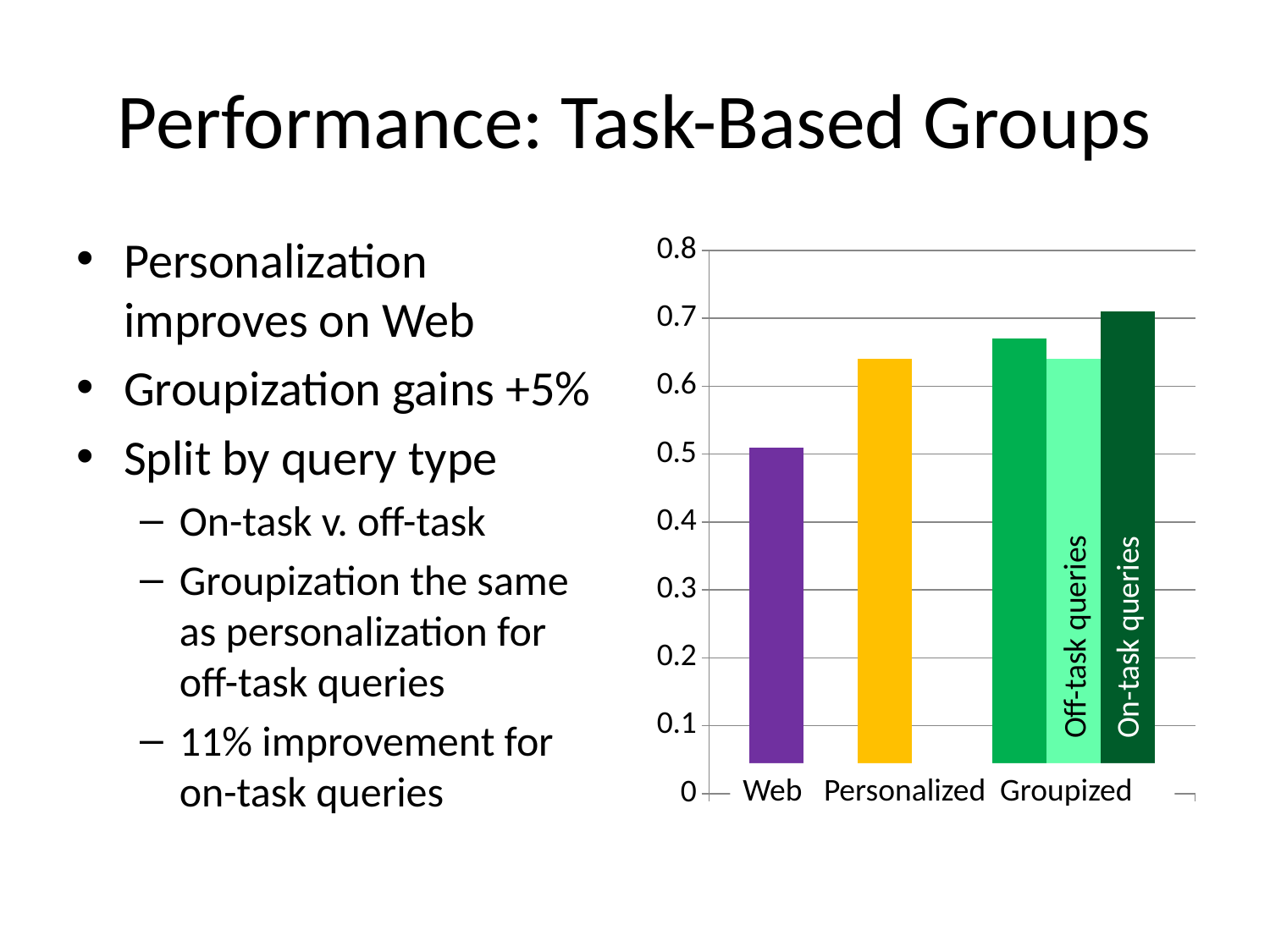
Which bar in the chart is the highest? On-task queries What is the highest value shown on the vertical axis? 0.8 Which is larger, the value for Web or the value for Personalized? Personalized Is the value for Personalized greater or less than 0.6? greater How many bars are plotted in the chart? 5 Is the value for Off-task queries greater or less than 0.6? greater Which bar in the chart is the lowest? Web Is the value for Groupized greater or less than 0.7? less Which is larger, the value for Off-task queries or the value for On-task queries? On-task queries What kind of chart is shown on the slide? bar chart What colour is the Web bar? purple